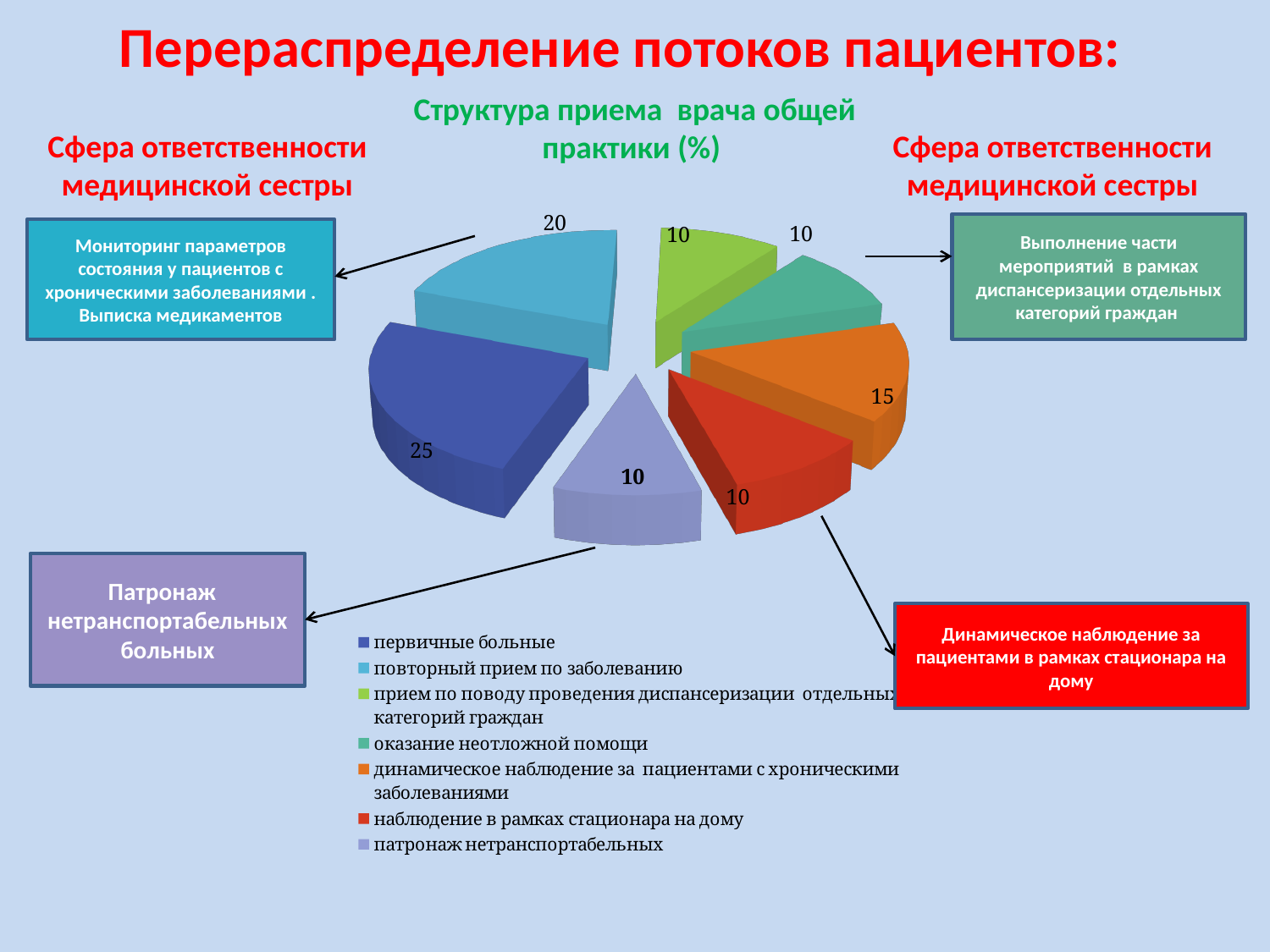
What is the chart's title? Структура приема врача общей практики (%) What kind of chart is shown on the slide? pie chart What is the value for "повторный прием по заболеванию"? 20 How many slices does the pie chart have? 7 Which category has the largest slice of the pie? первичные больные What is the value for "первичные больные"? 25 What is the value for "динамическое наблюдение за пациентами с хроническими заболеваниями"? 15 What is the value for "патронаж нетранспортабельных"? 10 How many entries does the legend list? 7 What is the difference between the values for "первичные больные" and "повторный прием по заболеванию"? 5 What colour is the slice for "наблюдение в рамках стационара на дому"? red Which is larger: "динамическое наблюдение за пациентами с хроническими заболеваниями" or "наблюдение в рамках стационара на дому"? динамическое наблюдение за пациентами с хроническими заболеваниями